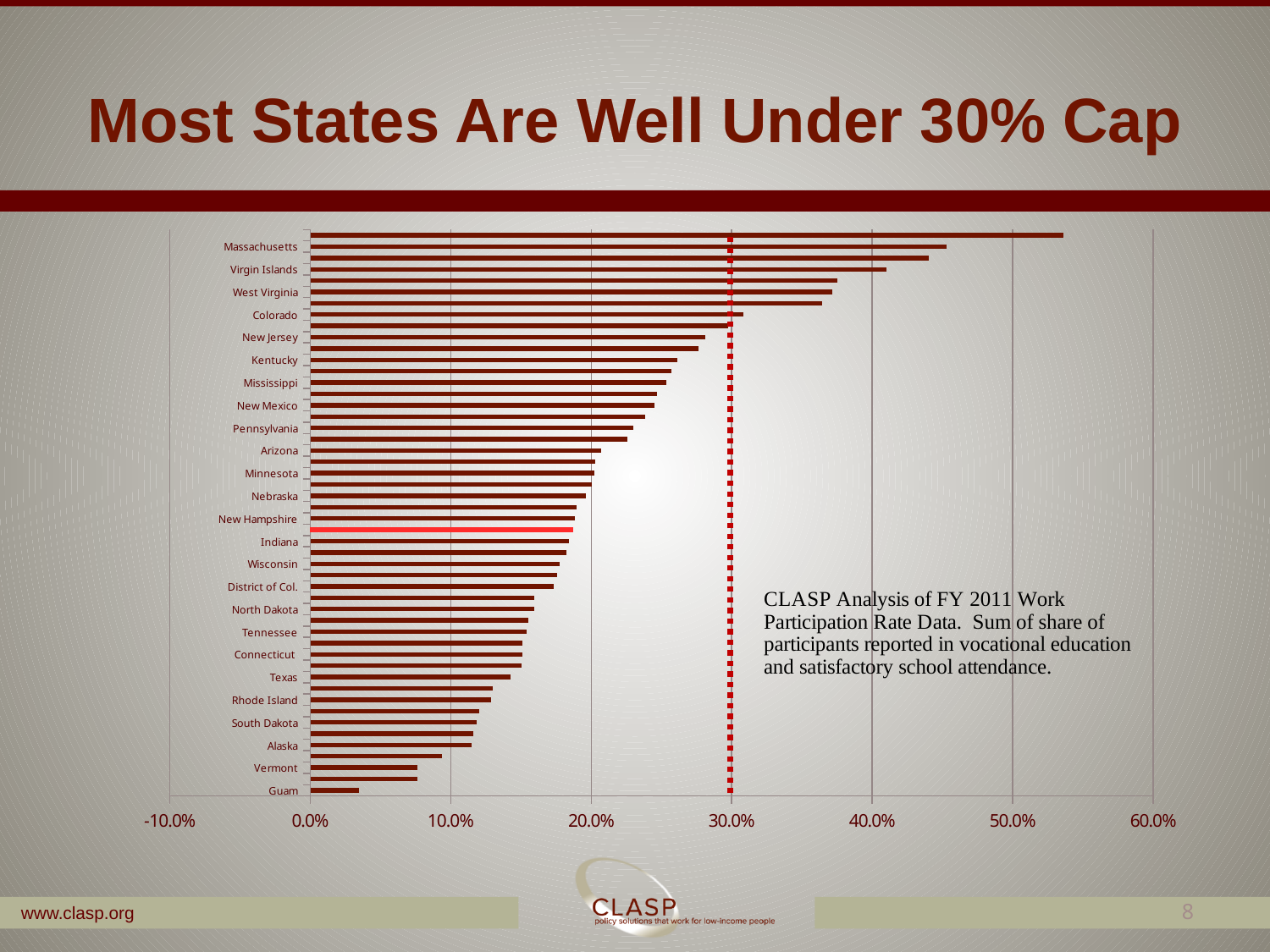
Is the value for Pennsylvania greater or less than 20.0%? greater Do the bar values rise or fall going from the top of the chart to the bottom? fall Which is larger, the value for Virgin Islands or the value for Vermont? Virgin Islands Is the value for Massachusetts greater or less than 40.0%? greater At what value on the x axis is the red dashed vertical line drawn? 30.0% Is the value for Guam greater or less than 10.0%? less What kind of chart is shown on the slide? bar chart What is the title of the slide containing the chart? Most States Are Well Under 30% Cap